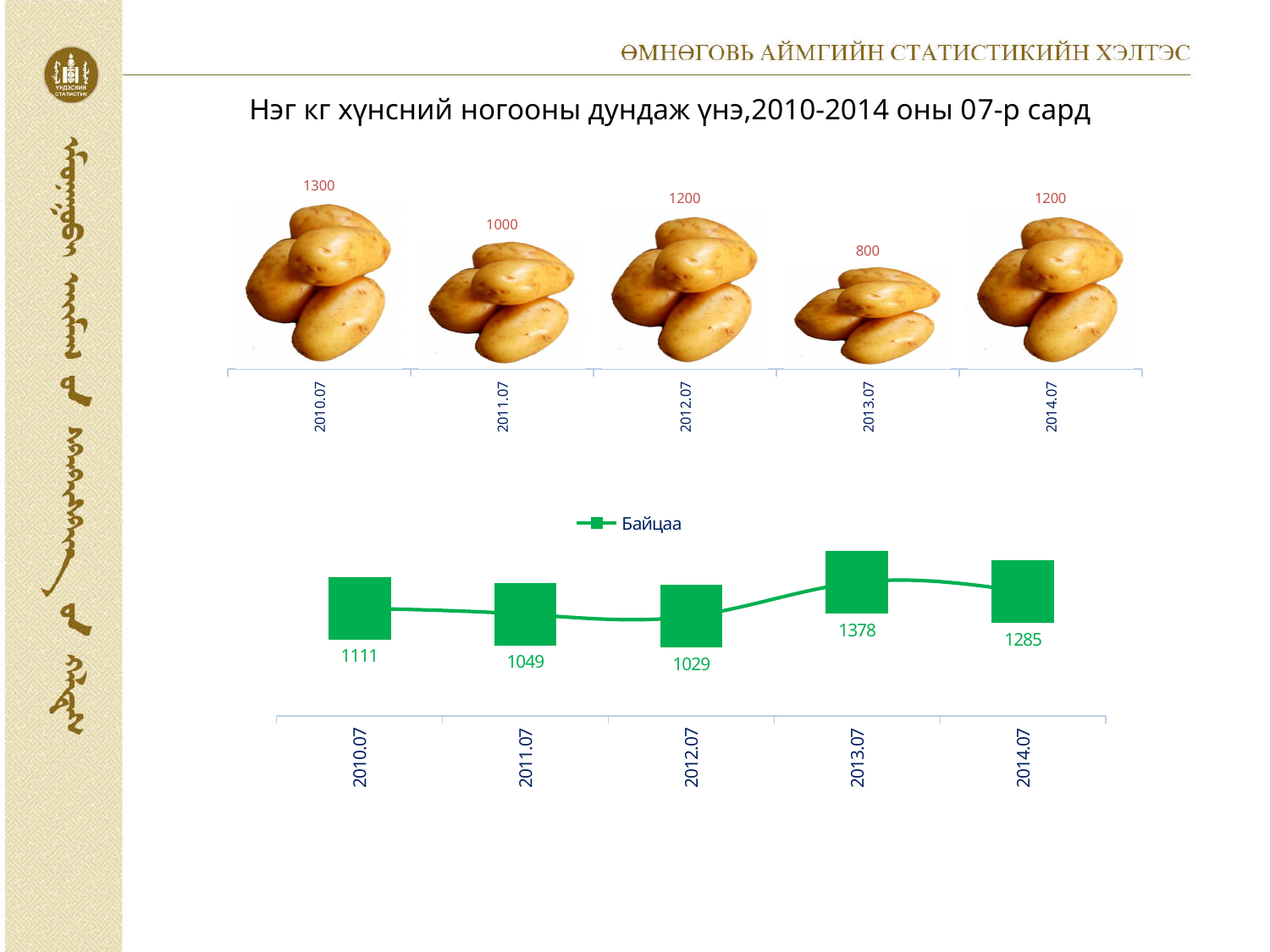
In the bottom chart (Байцаа), which period has the lowest value? 2012.07 In the bottom chart (Байцаа), what is the difference between the values for 2013.07 and 2014.07? 93 In the top chart with potato images, which period has the highest value? 2010.07 In the top chart with potato images, which period has the lowest value? 2013.07 In the top chart with potato images, what is the value for 2013.07? 800 In the bottom chart (Байцаа), which is larger, the value for 2010.07 or the value for 2014.07? 2014.07 In the bottom chart (Байцаа), what is the value for 2012.07? 1029 In the top chart with potato images, how many periods are shown on the x axis? 5 In the top chart with potato images, what is the value for 2010.07? 1300 In the top chart with potato images, what is the difference between the values for 2010.07 and 2011.07? 300 In the bottom chart (Байцаа), what is the value for 2013.07? 1378 In the bottom chart, what series name does the legend show? Байцаа